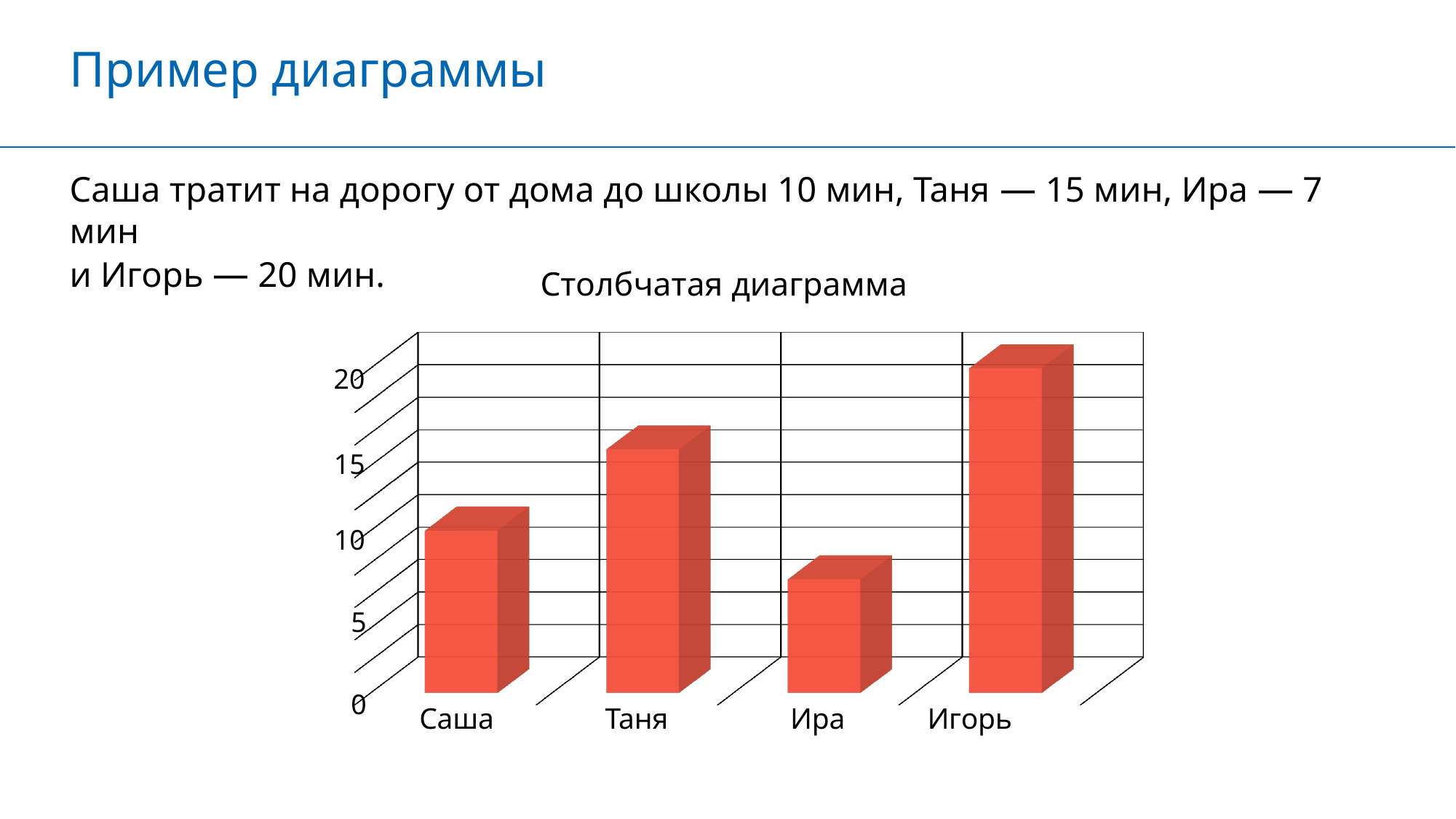
Which is larger, the value for Таня or the value for Саша? Таня What is the value for Игорь? 20 What is the value for Саша? 10 What is the value for Таня? 15 How many categories (people) are shown on the chart? 4 What is the difference between the values for Игорь and Саша? 10 What is the value for Ира? 7 Which category has the lowest bar? Ира What is the title of the chart? Столбчатая диаграмма Is the value for Ира greater or less than 10? less What kind of chart is shown on the slide? bar chart Which category has the highest bar? Игорь